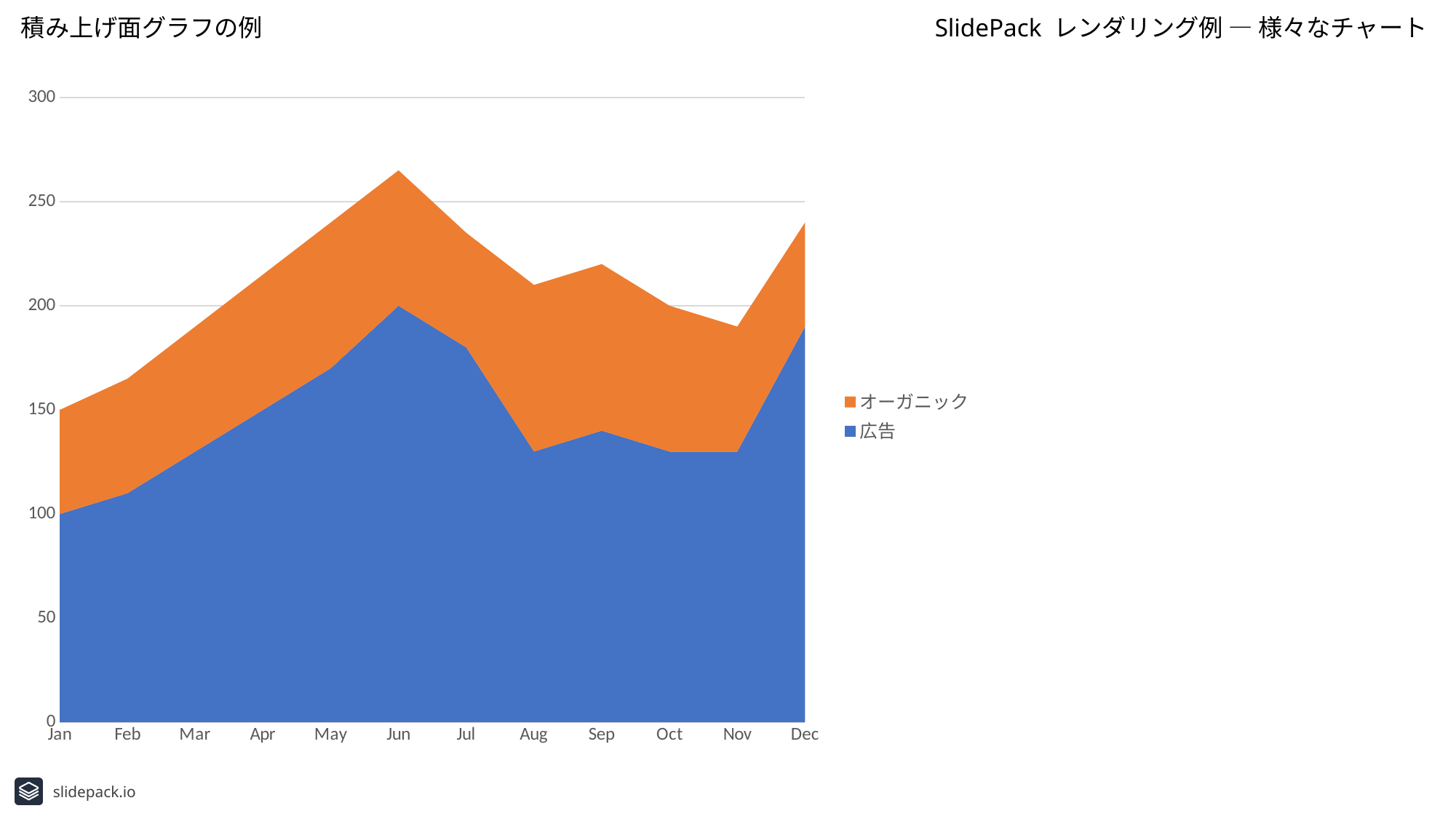
In which month is the value for 広告 lowest? Jan Does the value for 広告 rise or fall from Jan to Jun? rise Is the value for 広告 in Aug greater or less than 150? less What kind of chart is shown on the slide? stacked area chart How many months are shown along the x axis? 12 How many series does the legend list? 2 In which month is the stacked total (広告 plus オーガニック) highest? Jun In which month is the value for 広告 highest? Jun In which month is the stacked total (広告 plus オーガニック) lowest? Jan Which is larger, the value for 広告 in May or in Aug? May Is the value for 広告 in Dec greater or less than 150? greater Is the stacked total in Apr greater or less than 200? greater